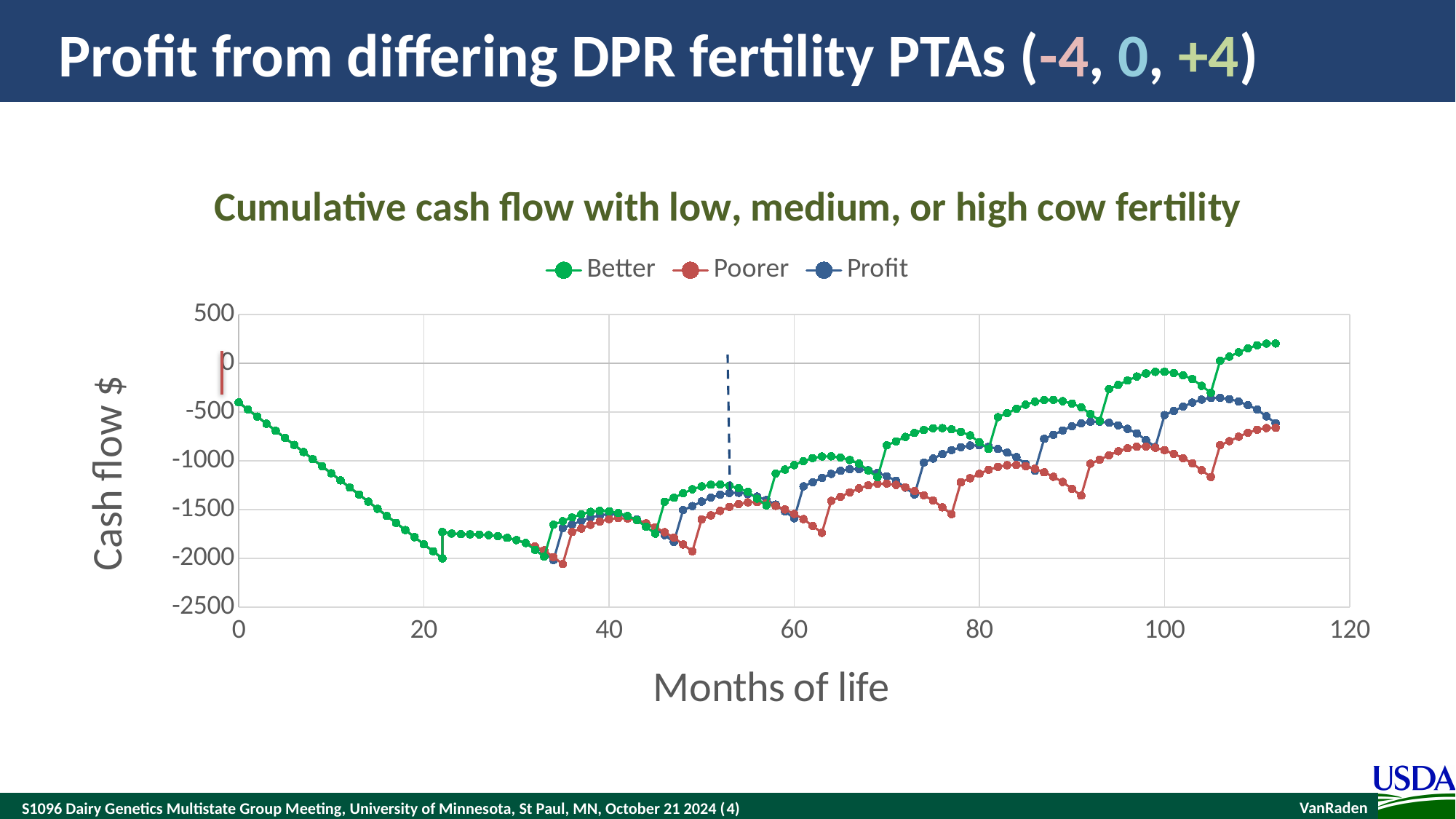
Is the value of the Better series at the end of the chart (around month 112) greater or less than 0? greater What kind of chart is shown on the slide? line chart Does the Better series rise or fall between month 0 and month 20? fall At the end of the chart (around month 112), which series is higher, Better or Profit? Better Is the value of the Better series at month 0 greater or less than -500? greater How many series does the legend list? 3 Is the value of the Profit series at month 100 greater or less than -1000? greater What is the title of the chart? Cumulative cash flow with low, medium, or high cow fertility What are the three series named in the legend? Better, Poorer, Profit Which series has the highest cash flow at the end of the chart (around month 112)? Better